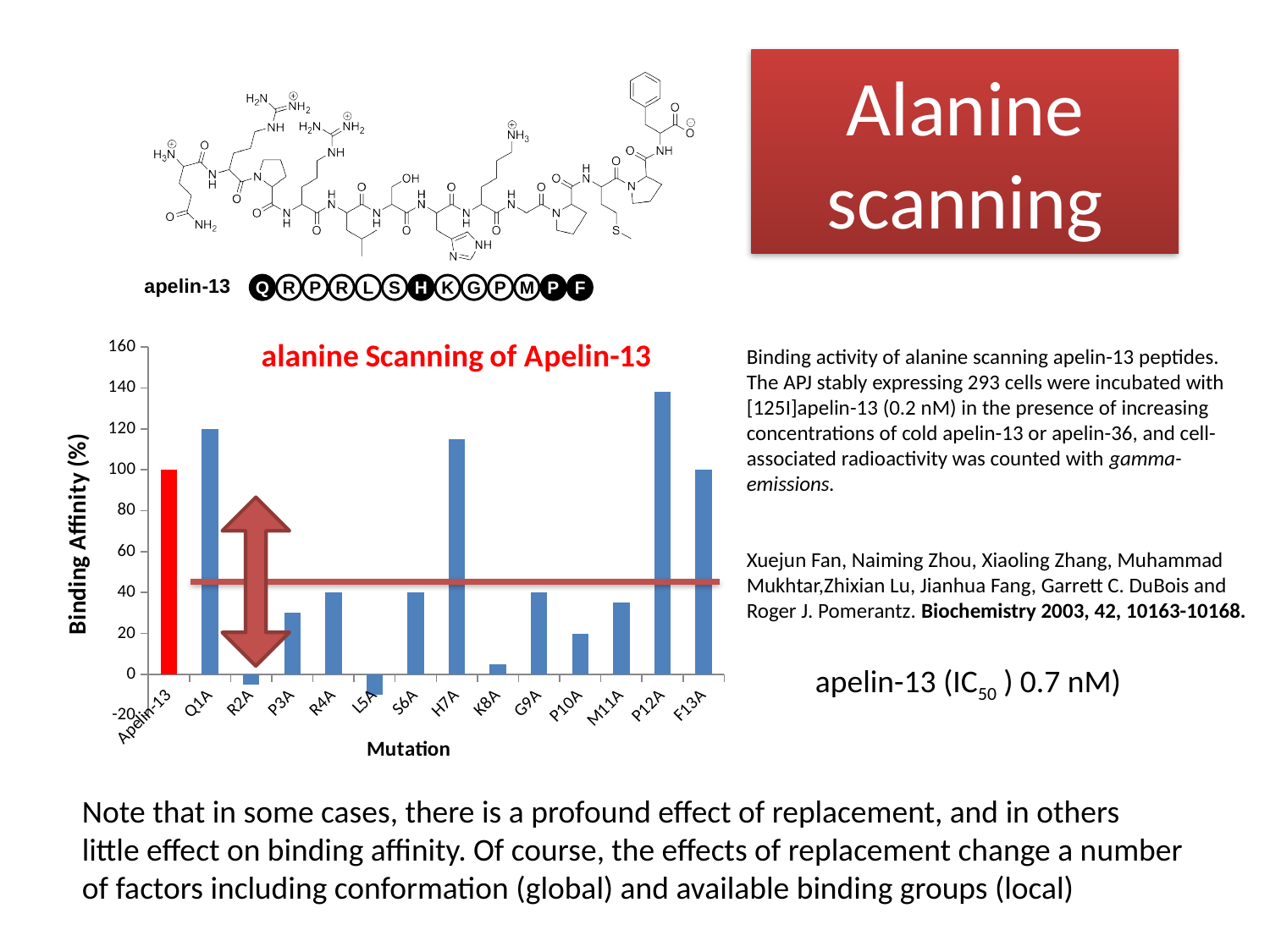
Is the binding affinity for H7A greater or less than 100? greater Which has a higher binding affinity, H7A or P3A? H7A Which mutation has the highest binding affinity in the chart? P12A Is the binding affinity for K8A greater or less than 20? less Which has a higher binding affinity, Q1A or R4A? Q1A Is the binding affinity for P10A greater or less than 40? less What is the title of the chart? alanine Scanning of Apelin-13 Which category has the lowest binding affinity in the chart? L5A How many categories are plotted along the x axis of the chart? 14 What kind of chart is shown on the slide? bar chart What is the label of the y axis of the chart? Binding Affinity (%)